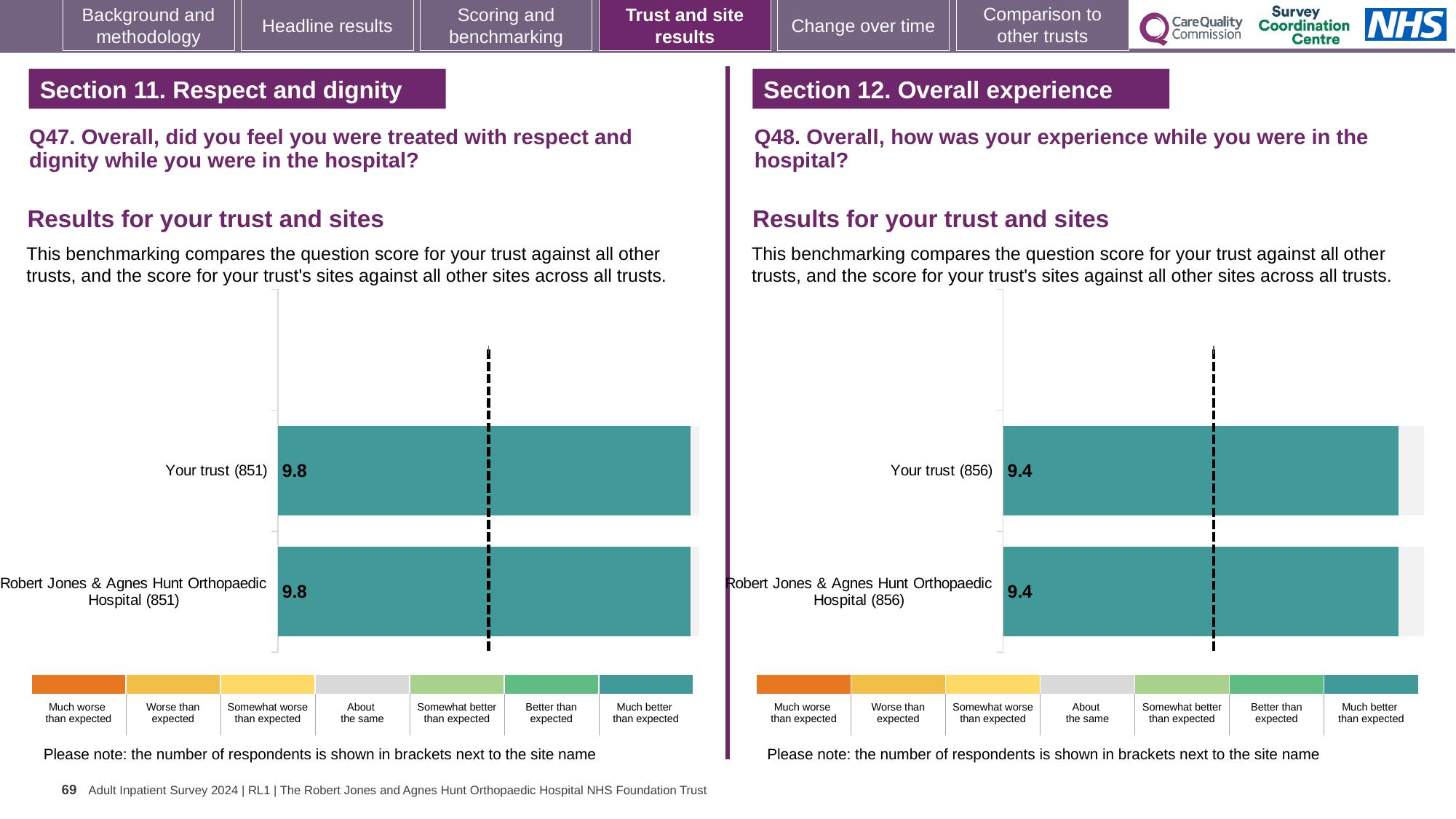
On the left chart (Q47, Section 11. Respect and dignity), what is the score for Your trust? 9.8 On the right chart (Q48, Section 12. Overall experience), what is the score for Your trust? 9.4 On the left chart (Q47, Section 11. Respect and dignity), what is the score for Robert Jones & Agnes Hunt Orthopaedic Hospital? 9.8 On the left chart (Q47), how many respondents are shown in brackets next to Your trust? 851 On the right chart (Q48), how many bars are plotted? 2 On the left chart (Q47), what is the difference between the score for Your trust and the score for Robert Jones & Agnes Hunt Orthopaedic Hospital? 0 On the left chart (Q47), how many bars are plotted? 2 On the right chart (Q48), what is the difference between the score for Your trust and the score for Robert Jones & Agnes Hunt Orthopaedic Hospital? 0 On the right chart (Q48, Section 12. Overall experience), what is the score for Robert Jones & Agnes Hunt Orthopaedic Hospital? 9.4 On the right chart (Q48), how many respondents are shown in brackets next to Robert Jones & Agnes Hunt Orthopaedic Hospital? 856 Is the score for Your trust on the left chart (Q47) larger than the score for Your trust on the right chart (Q48)? Yes What kind of chart is used on the left side of the slide for Q47? Bar chart